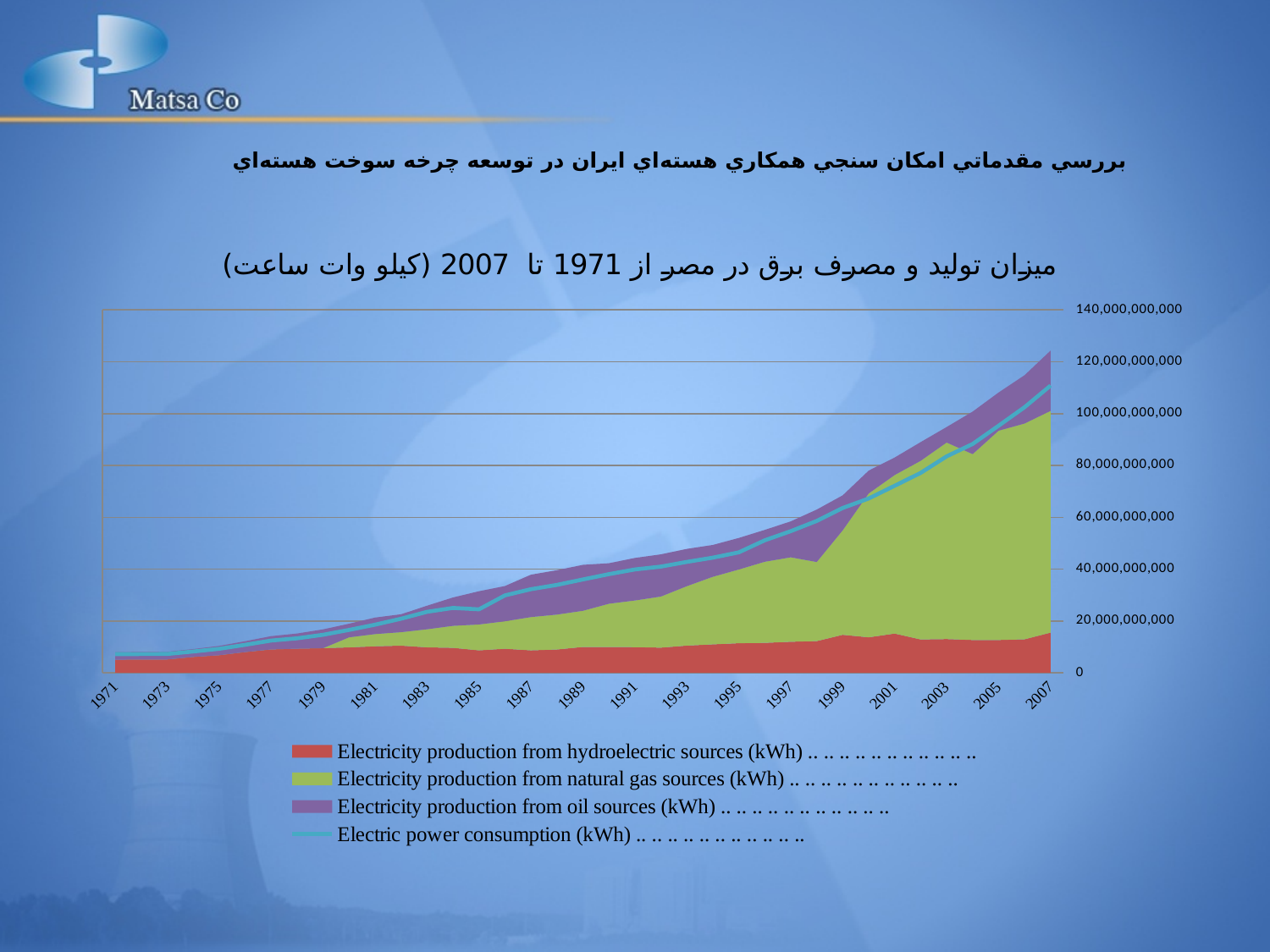
Is the value of Electricity production from hydroelectric sources (kWh) in 2007 greater or less than 20,000,000,000? less Which production source contributes the most electricity in 1971? Electricity production from hydroelectric sources (kWh) Which production source contributes the most electricity in 2007? Electricity production from natural gas sources (kWh) Does Electric power consumption (kWh) rise or fall from 1971 to 2007? rise What kind of chart is shown on the slide? Stacked area chart with a line Is the value of Electric power consumption (kWh) in 2001 greater or less than 60,000,000,000? greater Is the value of Electric power consumption (kWh) in 2007 greater or less than 100,000,000,000? greater In 2007, which is larger: Electricity production from natural gas sources or Electricity production from hydroelectric sources? Electricity production from natural gas sources What is the last year shown on the x axis? 2007 What is the first year shown on the x axis? 1971 How many series does the legend list? 4